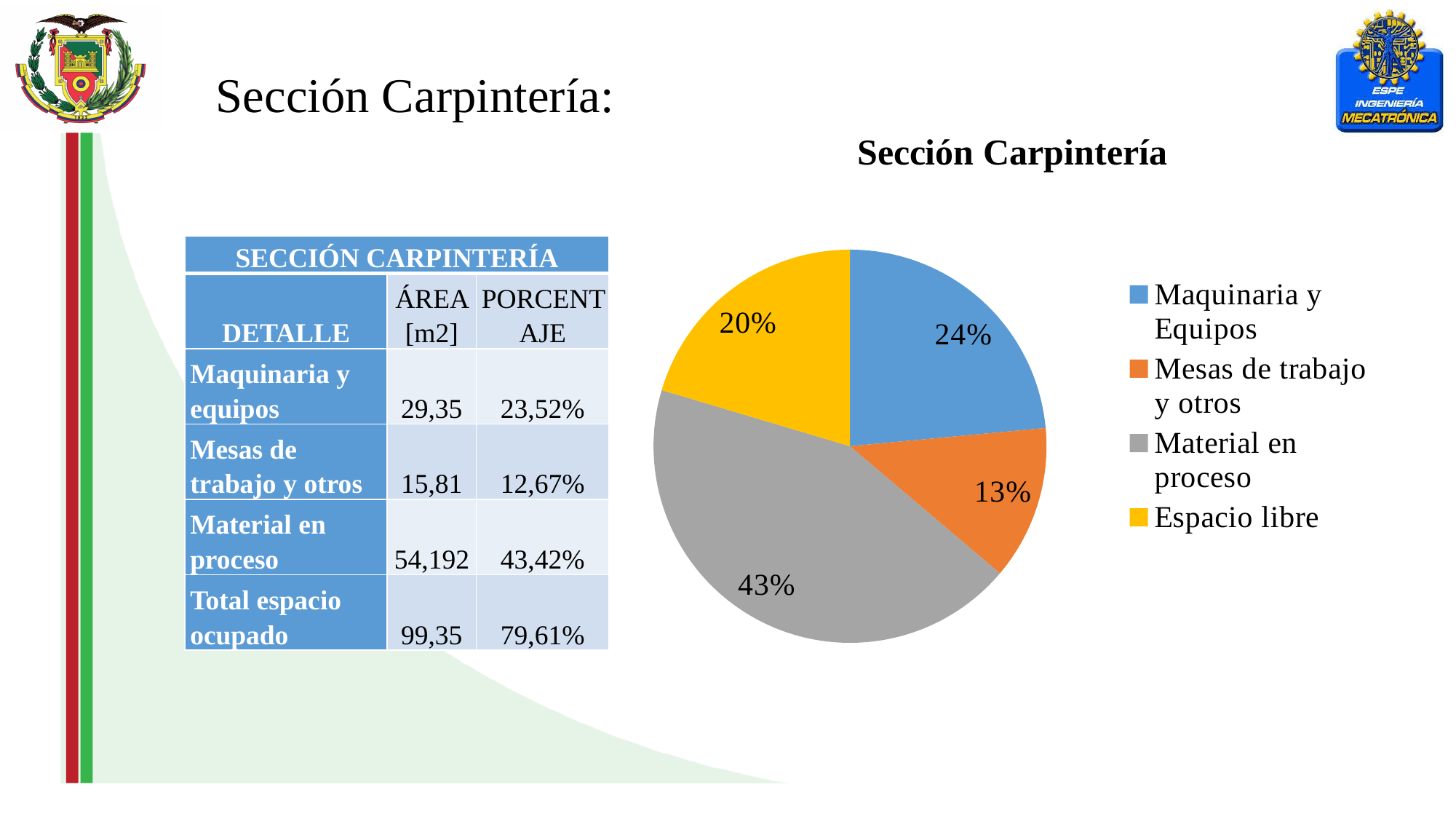
What share of the pie does Espacio libre take? 20% What share of the pie does Mesas de trabajo y otros take? 13% Which category has the largest slice of the pie? Material en proceso What share of the pie does Material en proceso take? 43% How many slices does the pie chart have? 4 Which category has the smallest slice of the pie? Mesas de trabajo y otros What is the difference in percentage points between the Material en proceso slice and the Mesas de trabajo y otros slice? 30% What colour is the slice for Espacio libre? yellow What is the title of the chart? Sección Carpintería What kind of chart is shown on the slide? pie chart Which is larger, the slice for Maquinaria y Equipos or the slice for Espacio libre? Maquinaria y Equipos